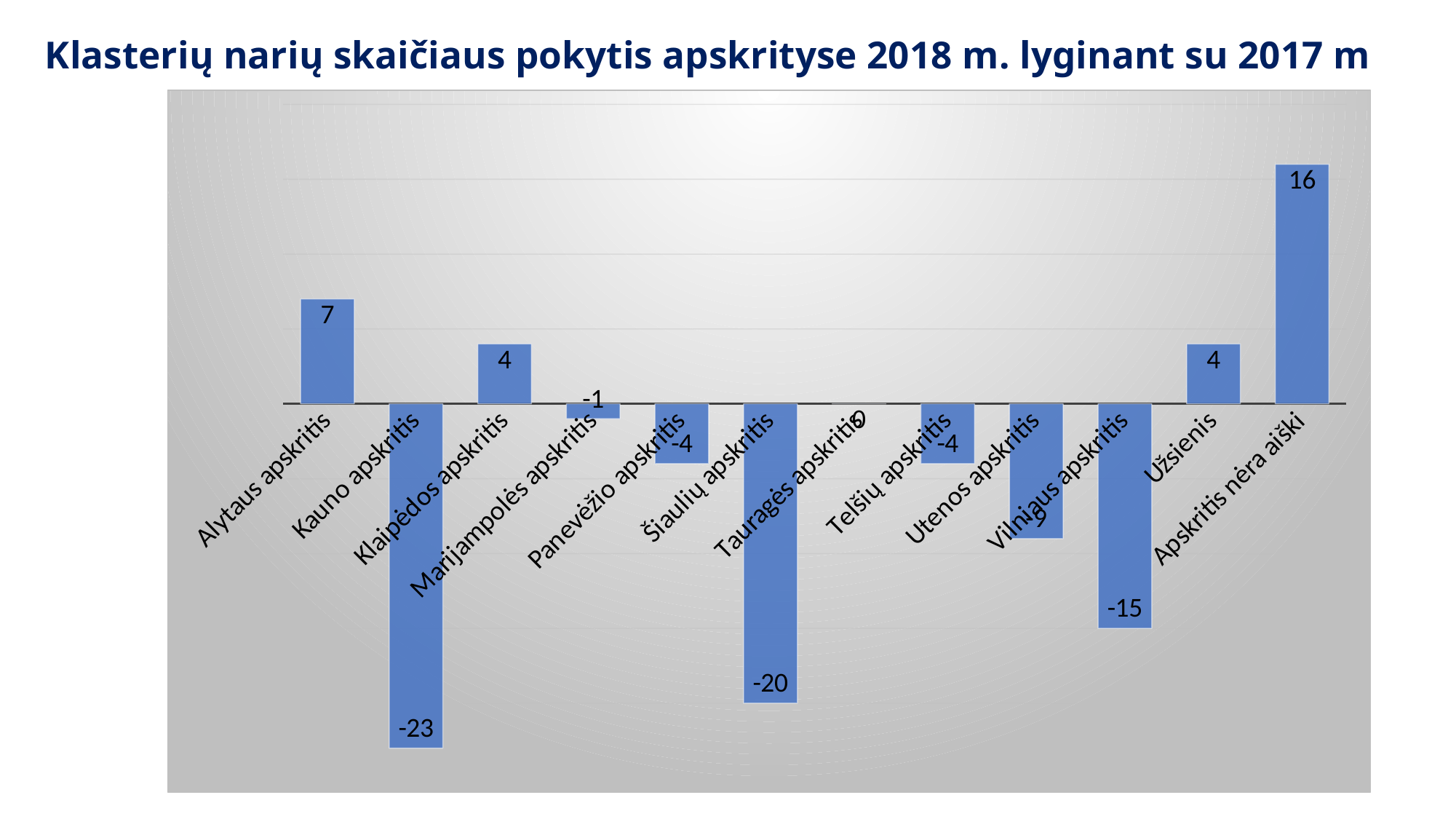
Which category has the lowest value? Kauno apskritis Which has the larger value, Šiaulių apskritis or Vilniaus apskritis? Vilniaus apskritis What is the value for Kauno apskritis? -23 What is the value for Tauragės apskritis? 0 What is the value for Apskritis nėra aiški? 16 What kind of chart is shown on the slide? Bar chart What is the difference between the values for Šiaulių apskritis and Kauno apskritis? 3 What is the value for Vilniaus apskritis? -15 How many categories are shown on the x axis? 12 What is the value for Alytaus apskritis? 7 Which category has the highest value? Apskritis nėra aiški What is the difference between the values for Alytaus apskritis and Klaipėdos apskritis? 3